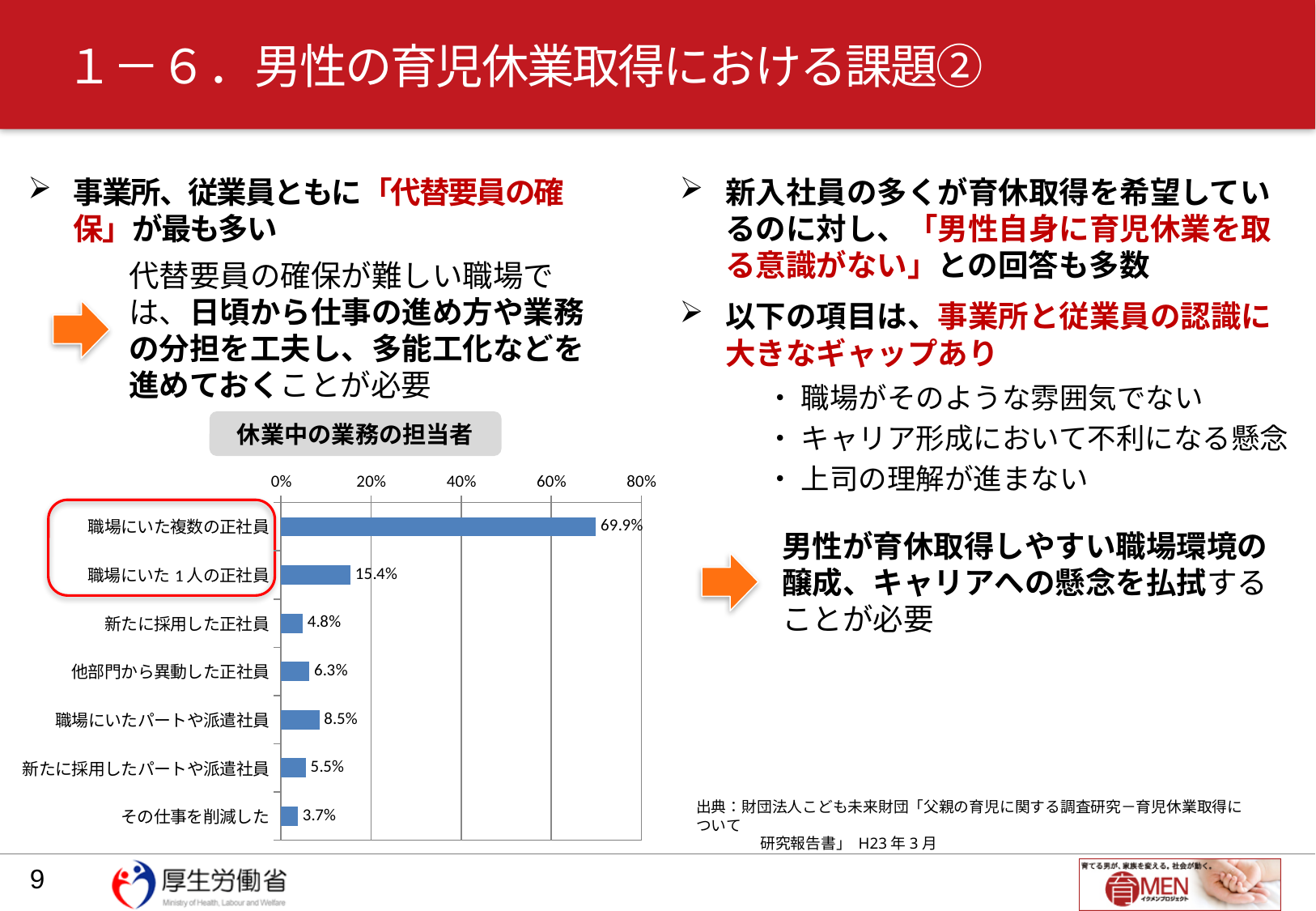
What is the value for 職場にいた１人の正社員 in the 休業中の業務の担当者 chart? 15.4% How many categories are shown in the 休業中の業務の担当者 chart? 7 What is the title of the chart on the slide? 休業中の業務の担当者 What kind of chart is the 休業中の業務の担当者 chart? bar chart Which category has the lowest value in the 休業中の業務の担当者 chart? その仕事を削減した Is the value for 職場にいた複数の正社員 greater or less than 60% in the 休業中の業務の担当者 chart? greater What is the value for 職場にいた複数の正社員 in the 休業中の業務の担当者 chart? 69.9% What is the value for その仕事を削減した in the 休業中の業務の担当者 chart? 3.7% What is the difference between 職場にいた複数の正社員 and 職場にいた１人の正社員 in the 休業中の業務の担当者 chart? 54.5% Which category has the highest value in the 休業中の業務の担当者 chart? 職場にいた複数の正社員 Which is larger in the 休業中の業務の担当者 chart: 他部門から異動した正社員 or 新たに採用した正社員? 他部門から異動した正社員 What is the value for 職場にいたパートや派遣社員 in the 休業中の業務の担当者 chart? 8.5%